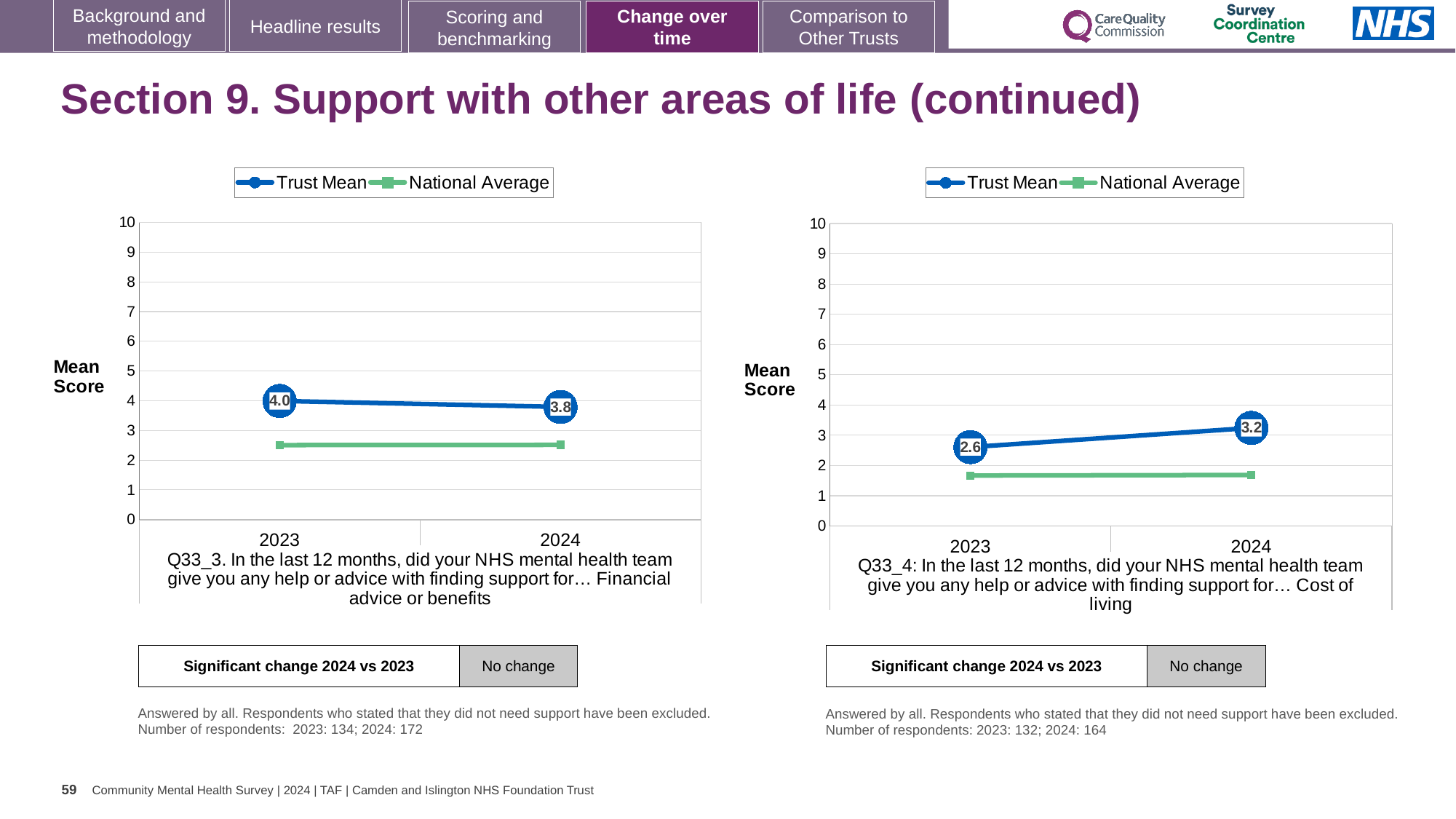
In the right chart (Q33_4, Cost of living), what is the Trust Mean score for 2024? 3.2 In the right chart (Q33_4), what is the difference between the Trust Mean for 2024 and 2023? 0.6 What kind of chart is the right chart (Q33_4)? line chart In the left chart (Q33_3), by how much did the Trust Mean change from 2023 to 2024? 0.2 In the right chart (Q33_4), does the Trust Mean rise or fall from 2023 to 2024? rise In the left chart (Q33_3, Financial advice or benefits), what is the Trust Mean score for 2023? 4.0 In the right chart (Q33_4), which series is higher in 2023, Trust Mean or National Average? Trust Mean In the left chart (Q33_3), is the National Average for 2024 greater or less than 3? less In the left chart (Q33_3), does the Trust Mean rise or fall from 2023 to 2024? fall How many series does the legend of the left chart list? 2 In the left chart (Q33_3, Financial advice or benefits), what is the Trust Mean score for 2024? 3.8 In the right chart (Q33_4, Cost of living), what is the Trust Mean score for 2023? 2.6